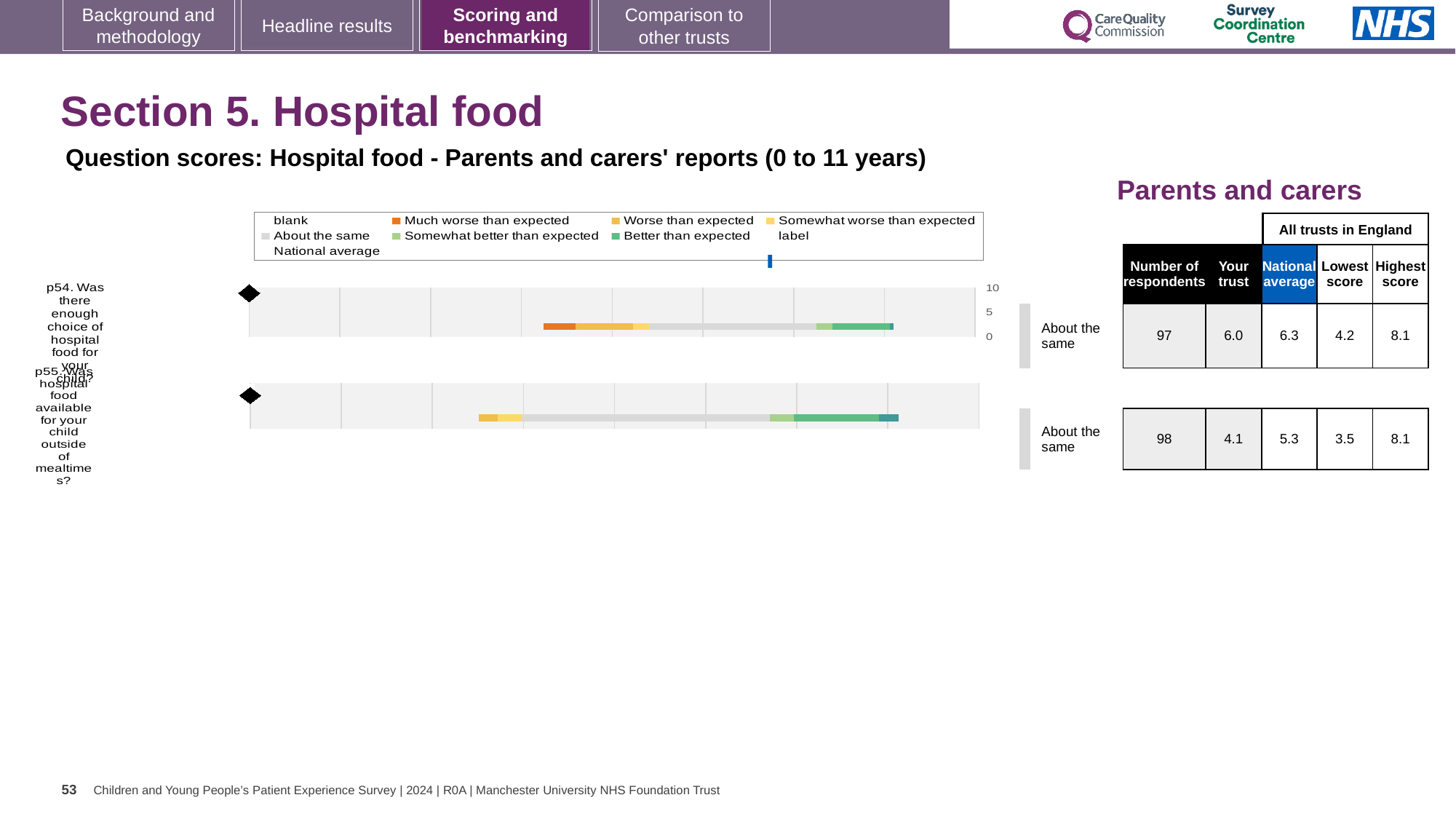
How many respondents are listed for question p54 (enough choice of hospital food)? 97 What kind of chart is used to show the question scores? bar chart What is the national average score for question p55 (hospital food available outside of mealtimes)? 5.3 What is the 'Your trust' score for question p54 (enough choice of hospital food)? 6.0 Which question has the higher 'Your trust' score, p54 or p55? p54 What benchmark category label is shown next to both question bars? About the same What is the lowest score across all trusts in England for question p55? 3.5 What is the difference between the national average and the 'Your trust' score for question p55? 1.2 Is the 'Your trust' score for p55 higher or lower than the national average for p55? lower How many survey questions are plotted in the chart? 2 What is the highest score across all trusts in England for question p54? 8.1 What is the difference between the highest and lowest scores for question p54? 3.9